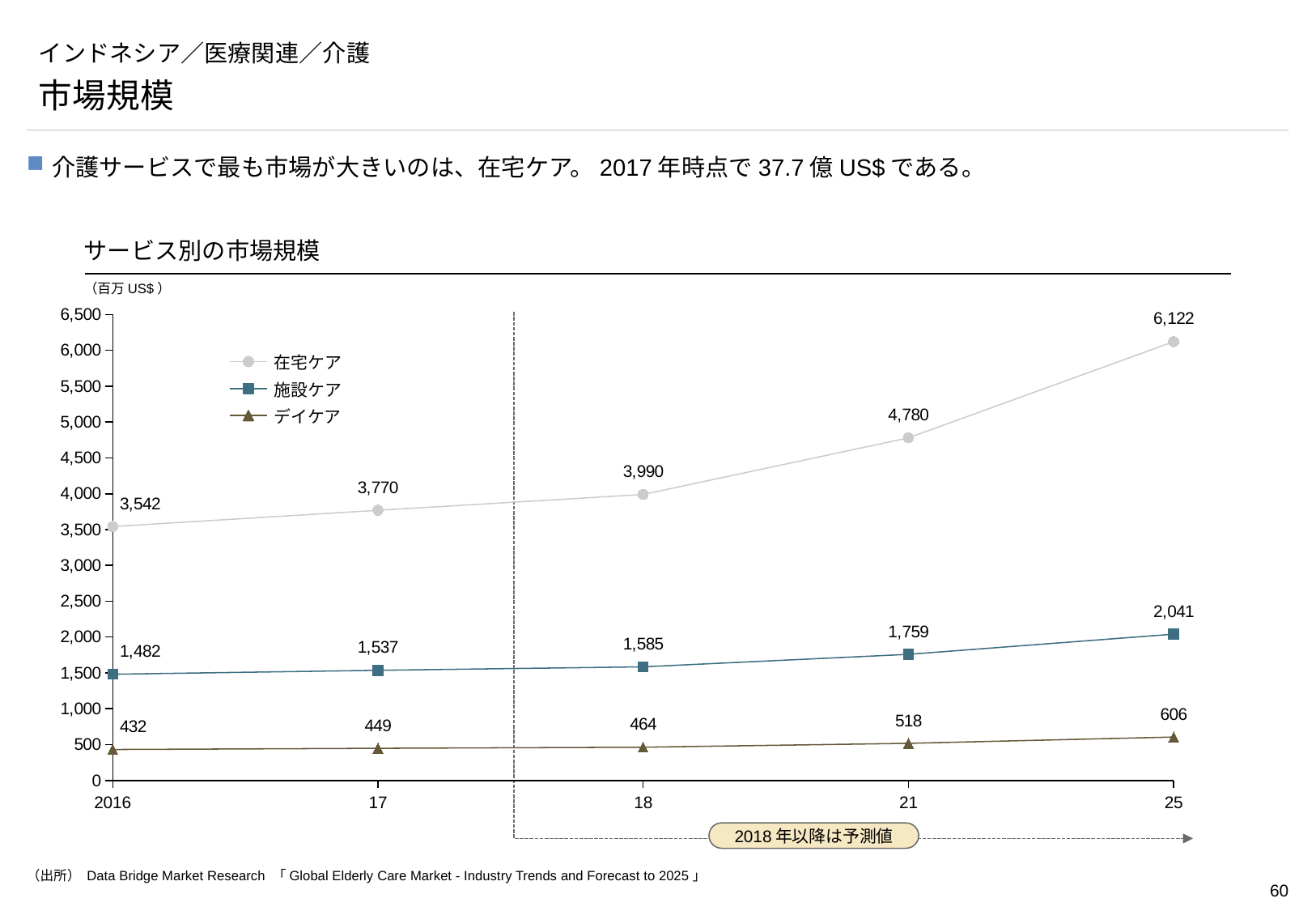
Which series has the highest value in 2025? 在宅ケア What is the value for 施設ケア in 2021? 1,759 How many series does the legend list? 3 Is the value for 在宅ケア in 2021 greater or less than 4,500? greater Which series has the lowest value in 2016? デイケア Do the values for 施設ケア rise or fall from 2016 to 2025? rise What kind of chart is shown? line chart What is the difference between the 在宅ケア values in 2025 and 2016? 2,580 How many years are shown on the x axis? 5 What is the value for デイケア in 2025? 606 Which is larger: 施設ケア in 2018 or デイケア in 2018? 施設ケア in 2018 What is the value for 在宅ケア in 2017? 3,770